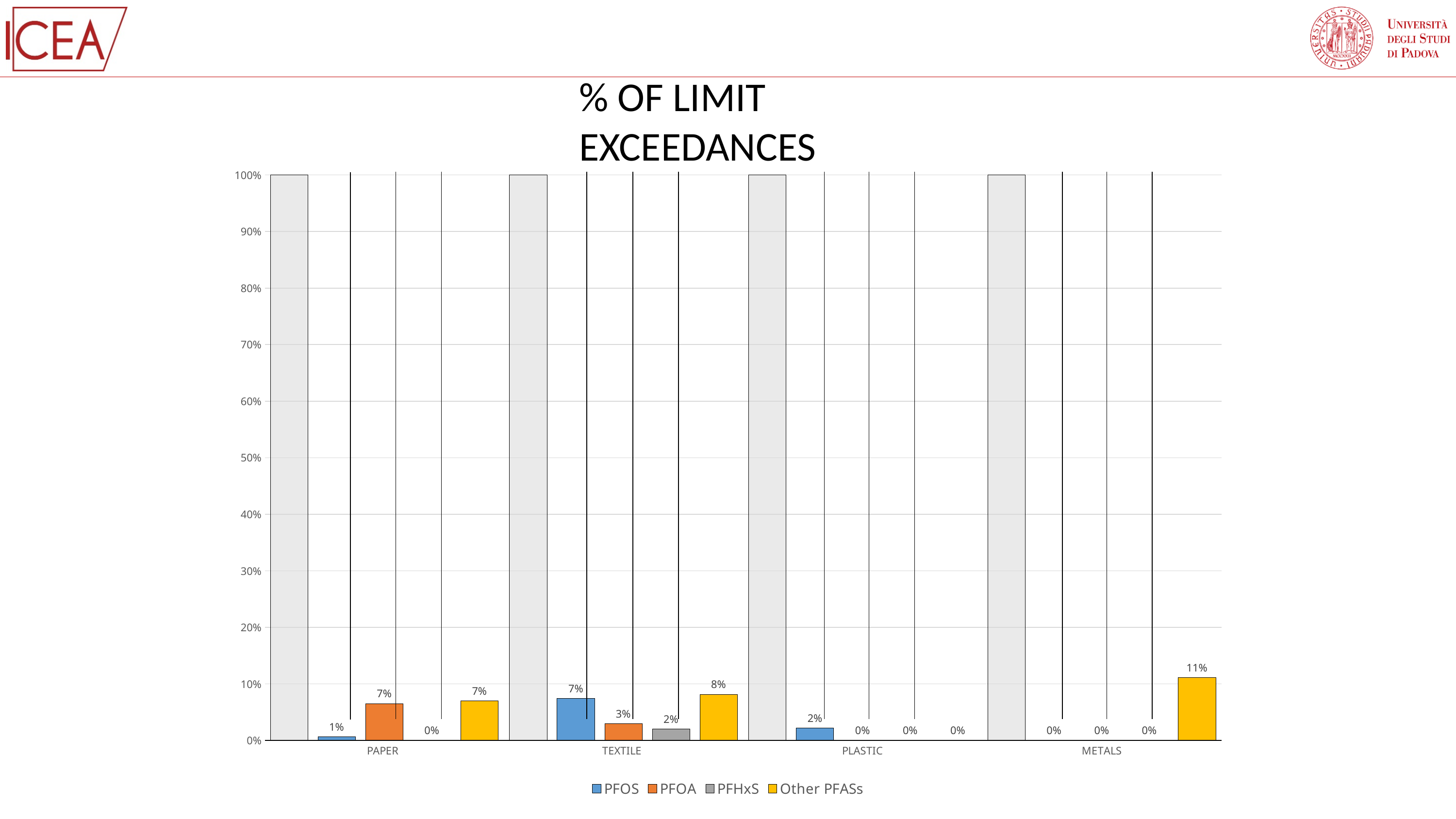
How many series does the legend list? 4 What is the value for PFHxS in the TEXTILE category? 2% Which category has the lowest value for PFOS? METALS What is the difference between the Other PFASs value for METALS and the Other PFASs value for TEXTILE? 3% Which category has the highest value for Other PFASs? METALS What is the title of the chart? % OF LIMIT EXCEEDANCES What is the value for PFOS in the TEXTILE category? 7% Which is larger in the TEXTILE category: PFOS or PFOA? PFOS What is the value for Other PFASs in the METALS category? 11% What is the value for PFOA in the PAPER category? 7% How many categories are shown on the x axis? 4 What kind of chart is shown on the slide? Bar chart